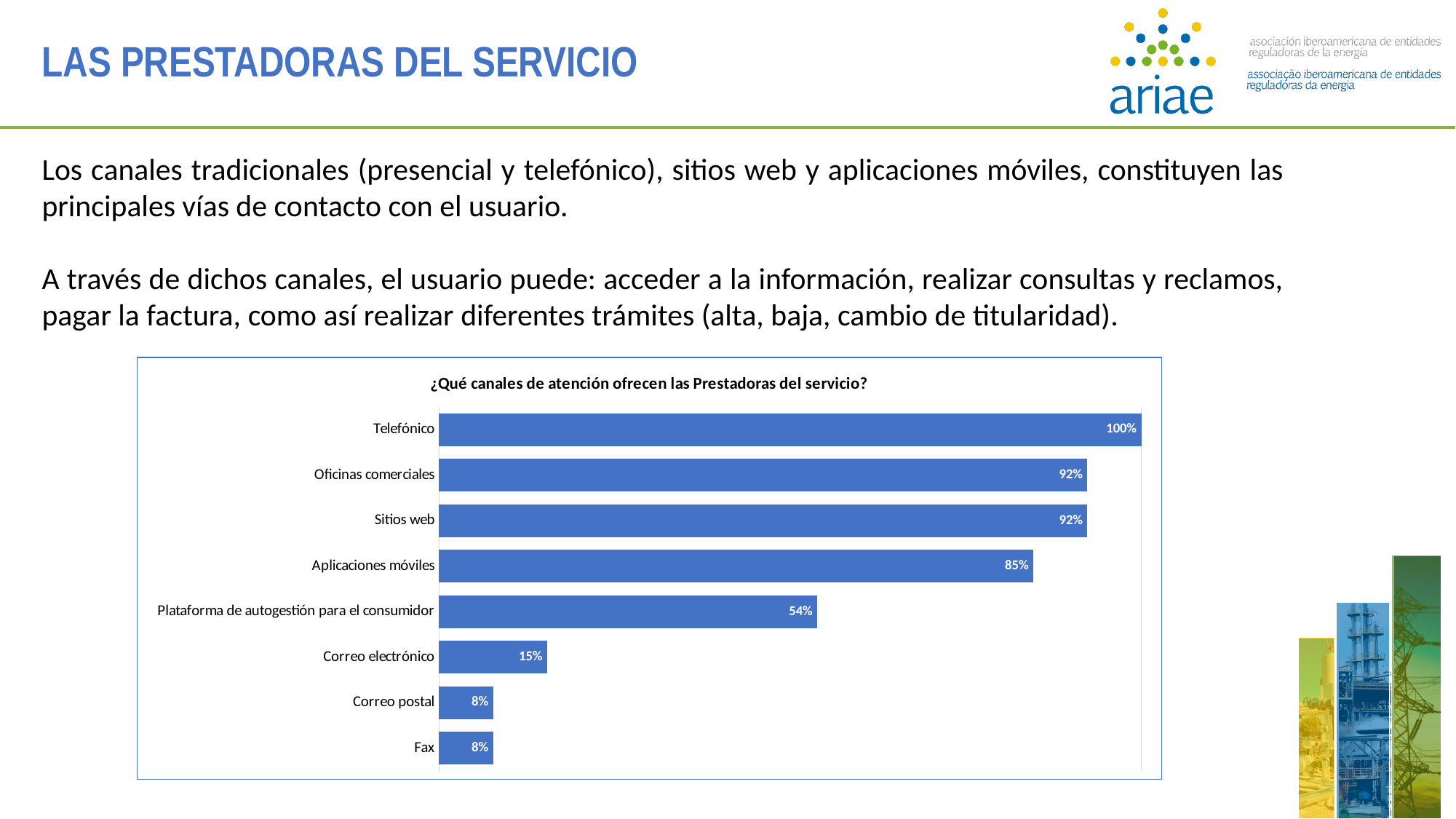
What is the value for Telefónico? 100% How many channels are shown in the chart? 8 What is the difference between the values for Plataforma de autogestión para el consumidor and Correo electrónico? 39% What is the title of the chart? ¿Qué canales de atención ofrecen las Prestadoras del servicio? Which channel has the highest value? Telefónico Which is larger, the value for Sitios web or the value for Aplicaciones móviles? Sitios web Which two channels share the value 92%? Oficinas comerciales and Sitios web What is the value for Aplicaciones móviles? 85% What is the value for Correo electrónico? 15% What kind of chart is shown on the slide? Bar chart What is the difference between the values for Telefónico and Aplicaciones móviles? 15% What is the value for Plataforma de autogestión para el consumidor? 54%